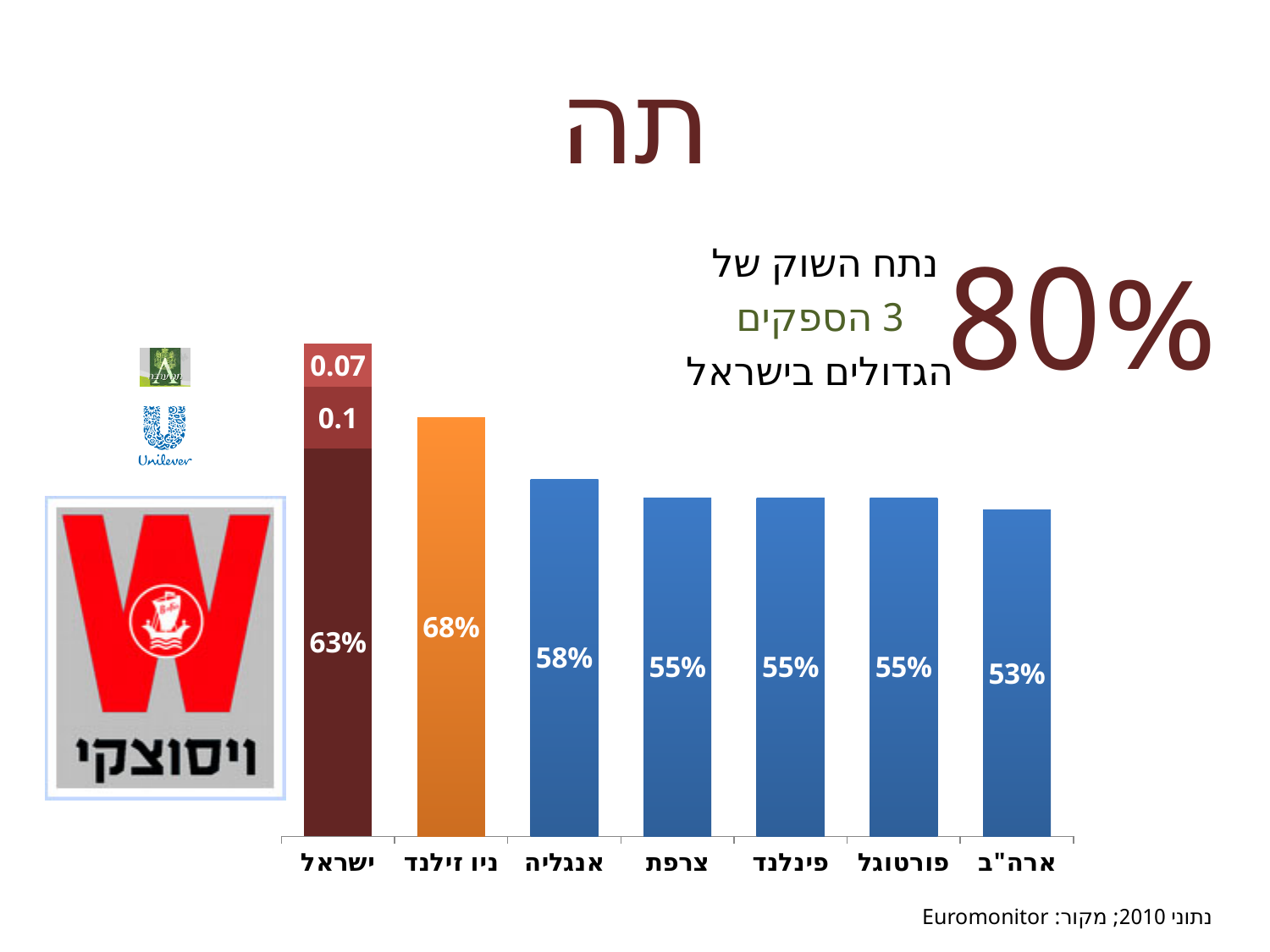
Which has a larger value, אנגליה (England) or צרפת (France)? אנגליה What is the value of the bottom (dark red) segment of the ישראל (Israel) bar? 63% How many countries share the value 55%? 3 What is the value shown for ארה"ב (USA)? 53% What is the value shown for ניו זילנד (New Zealand)? 68% What kind of chart is shown on the slide? Bar chart What is the difference between the values for ניו זילנד (New Zealand) and אנגליה (England)? 10 percentage points How many countries are shown on the x axis of the chart? 7 What is the value of the topmost segment of the ישראל (Israel) bar? 0.07 Which country has the lowest value in the chart? ארה"ב What is the value shown for אנגליה (England)? 58% What is the data source cited at the bottom of the slide? Euromonitor